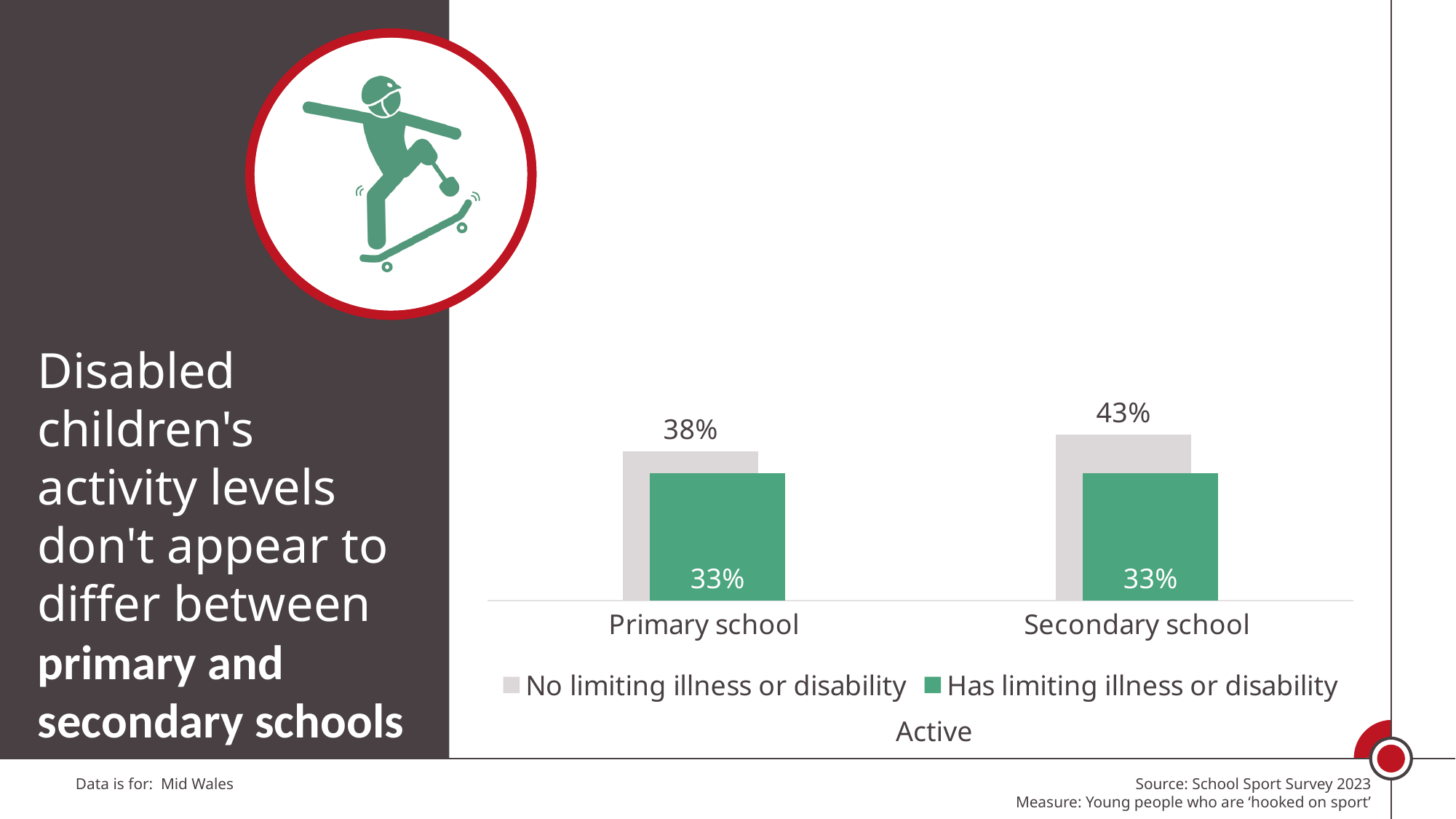
What is the difference between the 'No limiting illness or disability' values for Secondary school and Primary school? 5% What is the value for 'No limiting illness or disability' at Secondary school? 43% What is the difference between the 'No limiting illness or disability' and 'Has limiting illness or disability' values at Secondary school? 10% What is the label shown below the legend of the chart? Active Which school type has the highest value for 'No limiting illness or disability'? Secondary school How many series does the legend list? 2 What is the value for 'Has limiting illness or disability' at Primary school? 33% What is the value for 'No limiting illness or disability' at Primary school? 38% At Primary school, which is larger: 'No limiting illness or disability' or 'Has limiting illness or disability'? No limiting illness or disability How many school categories are shown on the x axis? 2 What kind of chart is shown on the slide? Bar chart What is the value for 'Has limiting illness or disability' at Secondary school? 33%